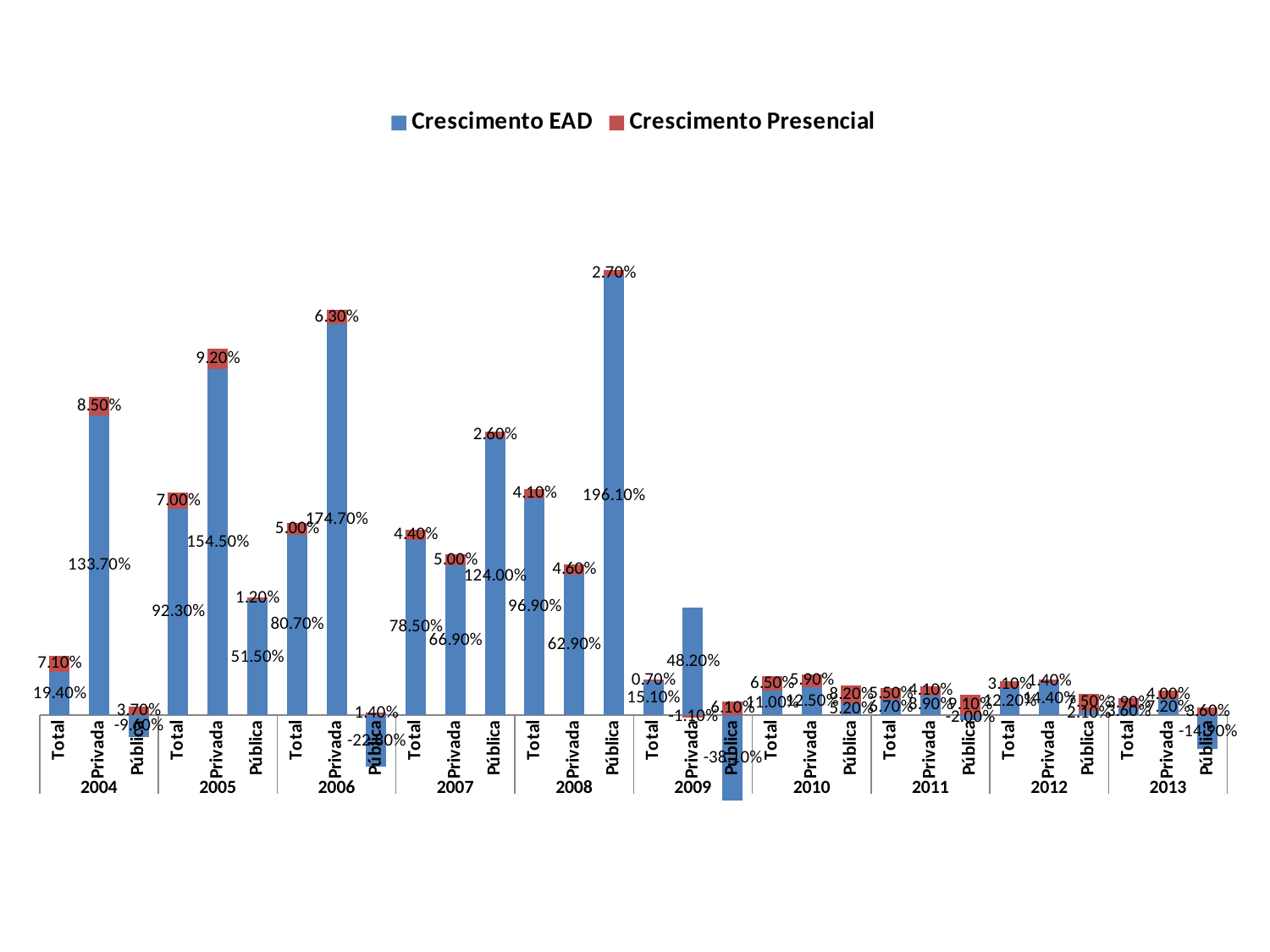
What is the Crescimento Presencial value for Privada in 2005? 9.20% Which bar has the highest Crescimento EAD value? Pública 2008 What is the Crescimento EAD value for Total in 2005? 92.30% What is the Crescimento EAD value for Pública in 2008? 196.10% What kind of chart is shown on the slide? bar chart Which is larger, the Crescimento EAD value for Privada in 2006 or for Privada in 2005? Privada 2006 What are the two series named in the legend? Crescimento EAD and Crescimento Presencial What is the difference between the Crescimento EAD values for Privada in 2006 (174.70%) and Privada in 2005 (154.50%)? 20.20% What is the Crescimento EAD value for Privada in 2004? 133.70% How many series does the legend list? 2 What is the Crescimento EAD value for Pública in 2007? 124.00% How many years are shown along the x axis? 10